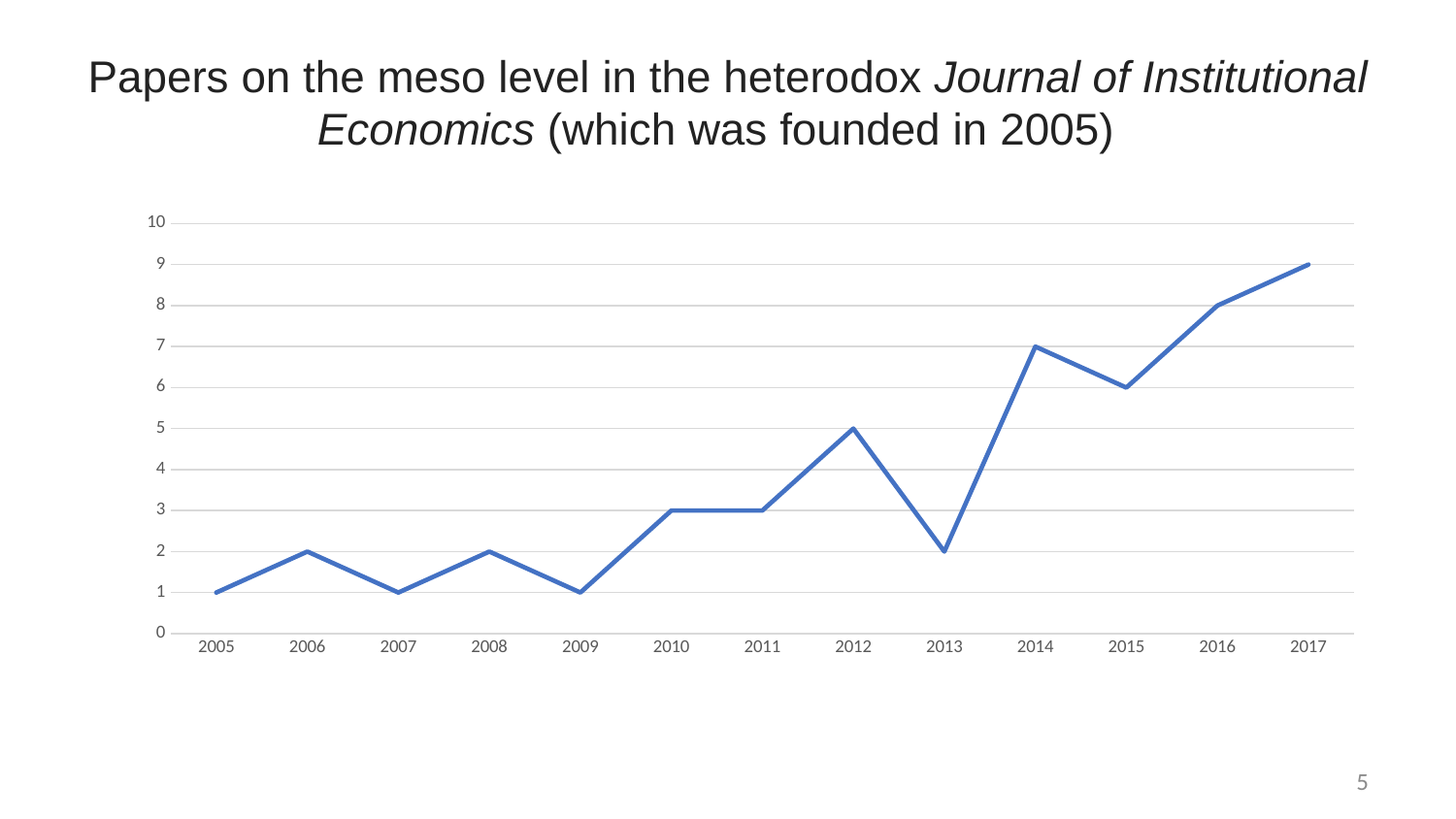
What is the value for 2014? 7 What is the highest value shown on the y axis? 10 Do the values generally rise or fall from 2005 to 2017? rise What is the value for 2017? 9 Which year has the lowest value, 2013 or 2015? 2013 Which year has the highest value? 2017 What is the difference between the values for 2014 and 2013? 5 Which is larger, the value for 2012 or the value for 2015? 2015 Is the value for 2016 greater or less than 5? greater How many years are plotted on the x axis? 13 What kind of chart is shown on the slide? line chart What is the value for 2012? 5